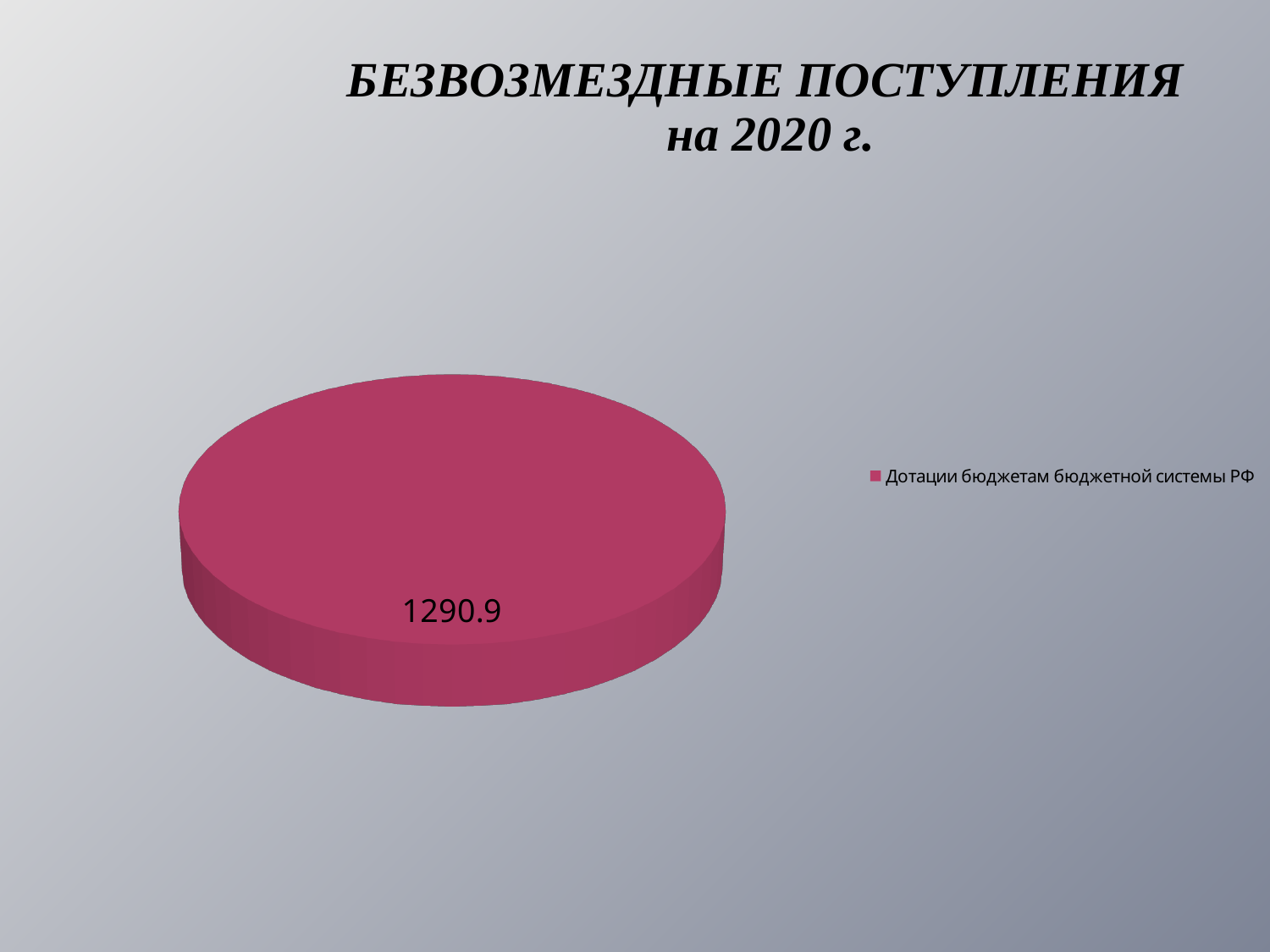
How many slices does the pie chart have? 1 How many entries does the legend list? 1 Is the value for Дотации бюджетам бюджетной системы РФ greater or less than 1000? greater What kind of chart is shown on the slide? pie chart What is the value shown for Дотации бюджетам бюджетной системы РФ? 1290.9 What is the title of the slide containing the chart? БЕЗВОЗМЕЗДНЫЕ ПОСТУПЛЕНИЯ на 2020 г. What is the legend entry shown for the pie chart? Дотации бюджетам бюджетной системы РФ What share of the pie does the Дотации бюджетам бюджетной системы РФ slice represent? 100%